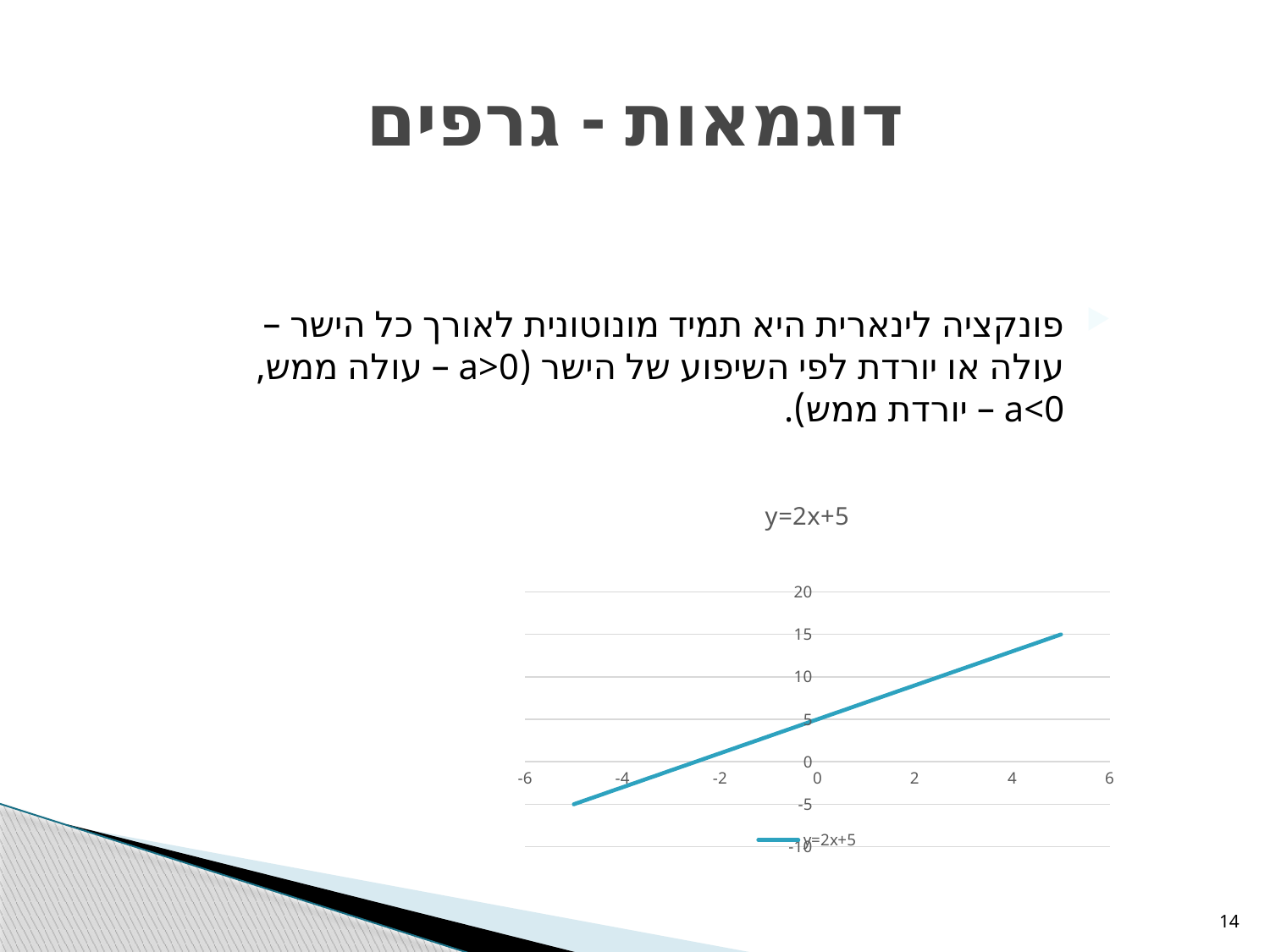
Is the value of the line at x = 4 greater or less than 10? greater At which end of the x axis, left or right, does the line reach its highest value? right Which is larger, the value of the line at x = 4 or at x = -4? x = 4 Is the value of the line at x = -2 greater or less than 5? less What is the value of the line where it crosses the y axis (x = 0)? 5 What kind of chart is shown on the slide? line chart How many series does the chart legend list? 1 Do the values of the line rise or fall as x increases along the x axis? rise What is the legend entry for the plotted line? y=2x+5 Is the value of the line at x = 2 greater or less than 5? greater What is the title of the chart? y=2x+5